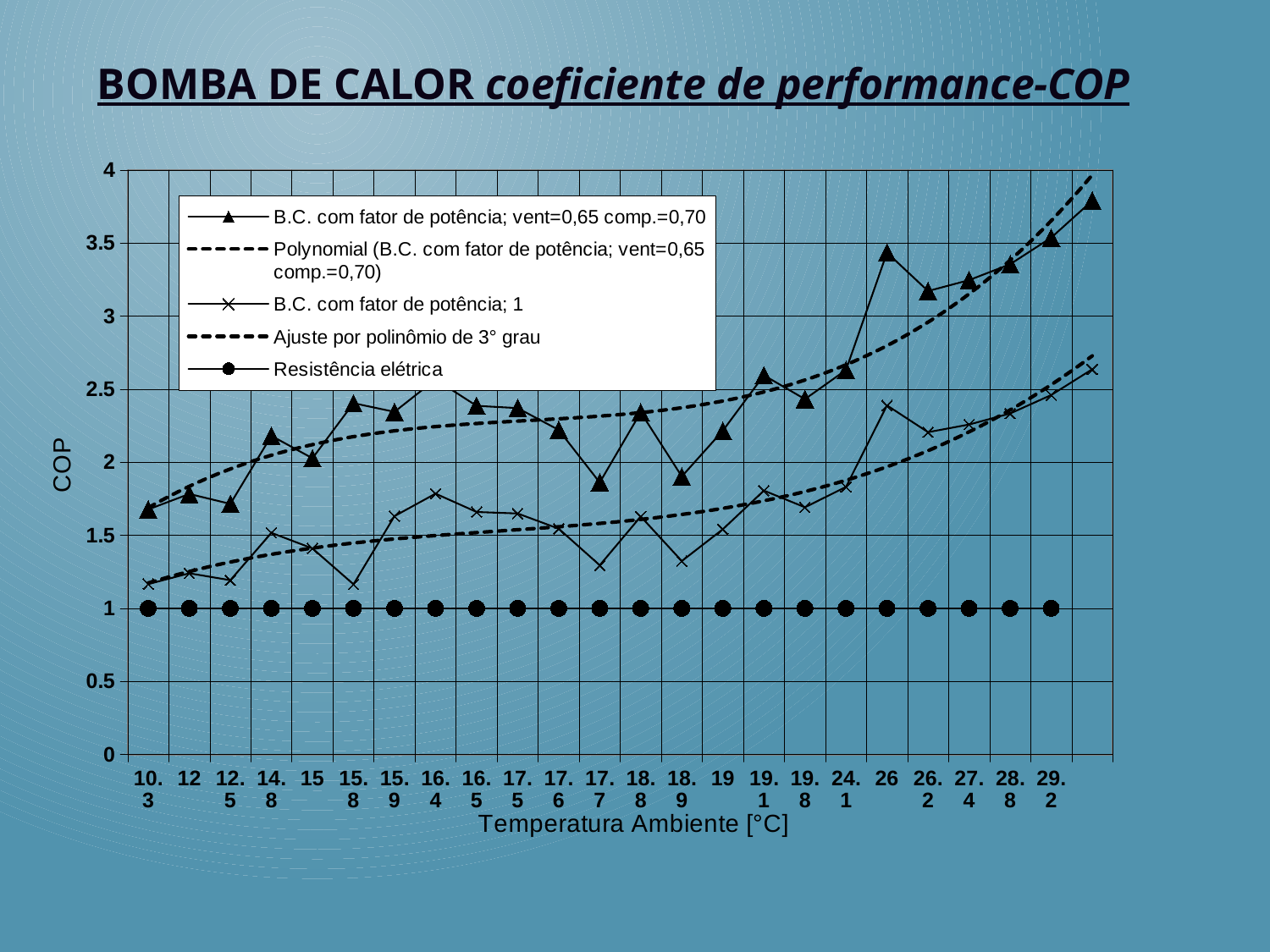
What is the value of the 'Resistência elétrica' series at 10.3 °C? 1 Is the value of 'B.C. com fator de potência; 1' at 10.3 °C greater or less than 1.5? less What is the label of the y axis? COP How many series does the legend list? 5 Is the value of 'B.C. com fator de potência; vent=0,65 comp.=0,70' at 17.7 °C greater or less than 2? less How many temperature categories are shown on the x axis? 23 What kind of chart is shown on the slide? line chart Does the 'B.C. com fator de potência; 1' series generally rise or fall as temperature increases along the x axis? rise At 26 °C, which series has the larger value: 'B.C. com fator de potência; vent=0,65 comp.=0,70' or 'B.C. com fator de potência; 1'? B.C. com fator de potência; vent=0,65 comp.=0,70 What is the value of the 'Resistência elétrica' series at 26 °C? 1